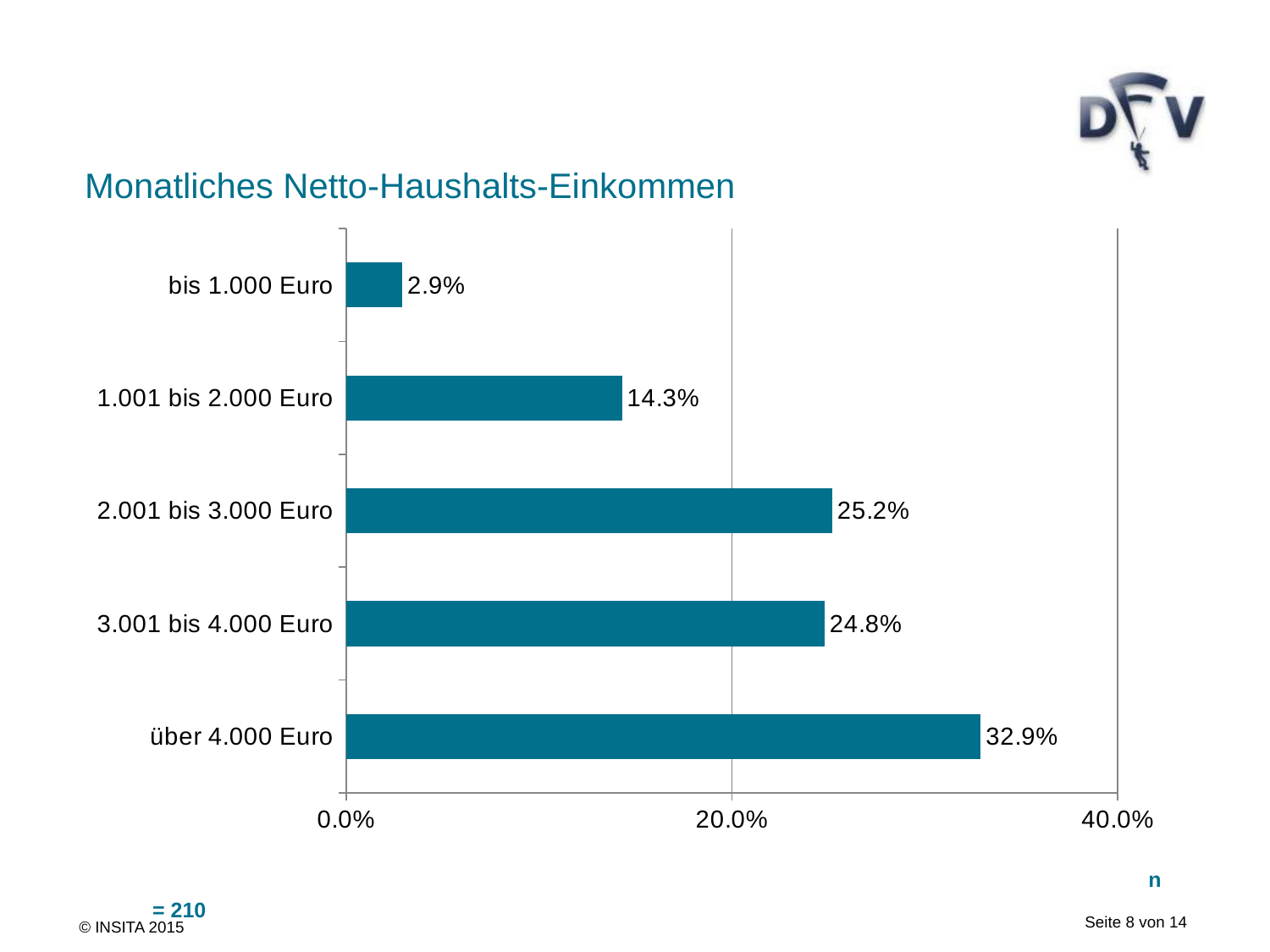
What is the title of the chart? Monatliches Netto-Haushalts-Einkommen What kind of chart is shown on the slide? bar chart What is the difference between the values for "über 4.000 Euro" and "2.001 bis 3.000 Euro"? 7.7% Which income category has the highest value? über 4.000 Euro What is the value for "1.001 bis 2.000 Euro"? 14.3% Which income category has the lowest value? bis 1.000 Euro What is the value for "bis 1.000 Euro"? 2.9% Which is larger, the value for "1.001 bis 2.000 Euro" or the value for "3.001 bis 4.000 Euro"? 3.001 bis 4.000 Euro What is the value for "3.001 bis 4.000 Euro"? 24.8% What is the sample size (n) stated on the slide? 210 Is the value for "2.001 bis 3.000 Euro" greater or less than 20.0%? greater How many income categories are shown in the chart? 5